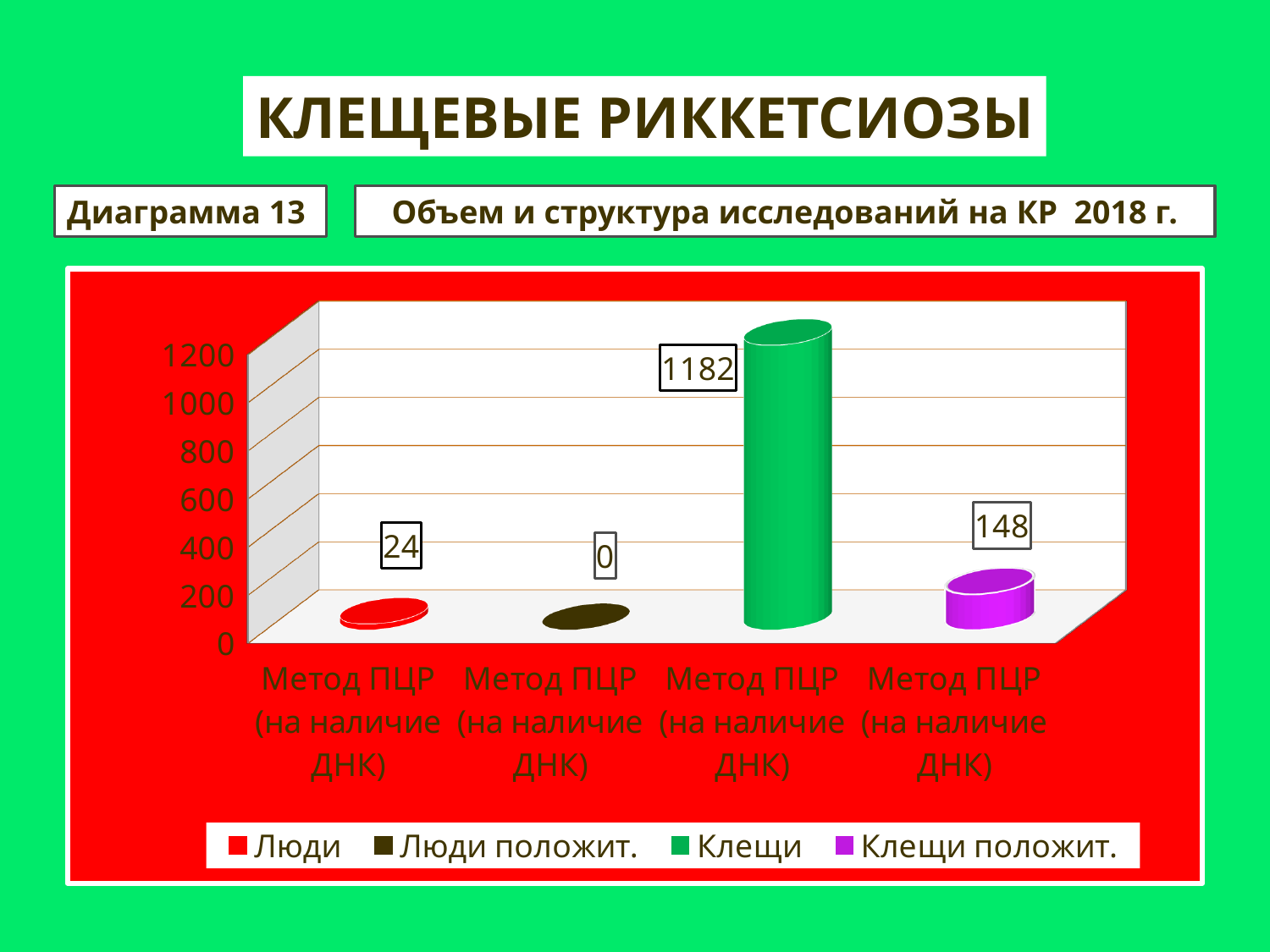
What is the difference between the values for "Клещи" and "Клещи положит."? 1034 How many series does the legend list? 4 Which is larger, the value for "Люди" or the value for "Клещи положит."? Клещи положит. Is the value for "Клещи" greater or less than 1000? greater What is the value for the series "Клещи положит."? 148 What is the value for the series "Люди"? 24 Which series has the highest value? Клещи What is the value for the series "Люди положит."? 0 Which series has the lowest value? Люди положит. What kind of chart is shown on the slide? bar chart What is the difference between the values for "Клещи положит." and "Люди"? 124 What is the value for the series "Клещи"? 1182